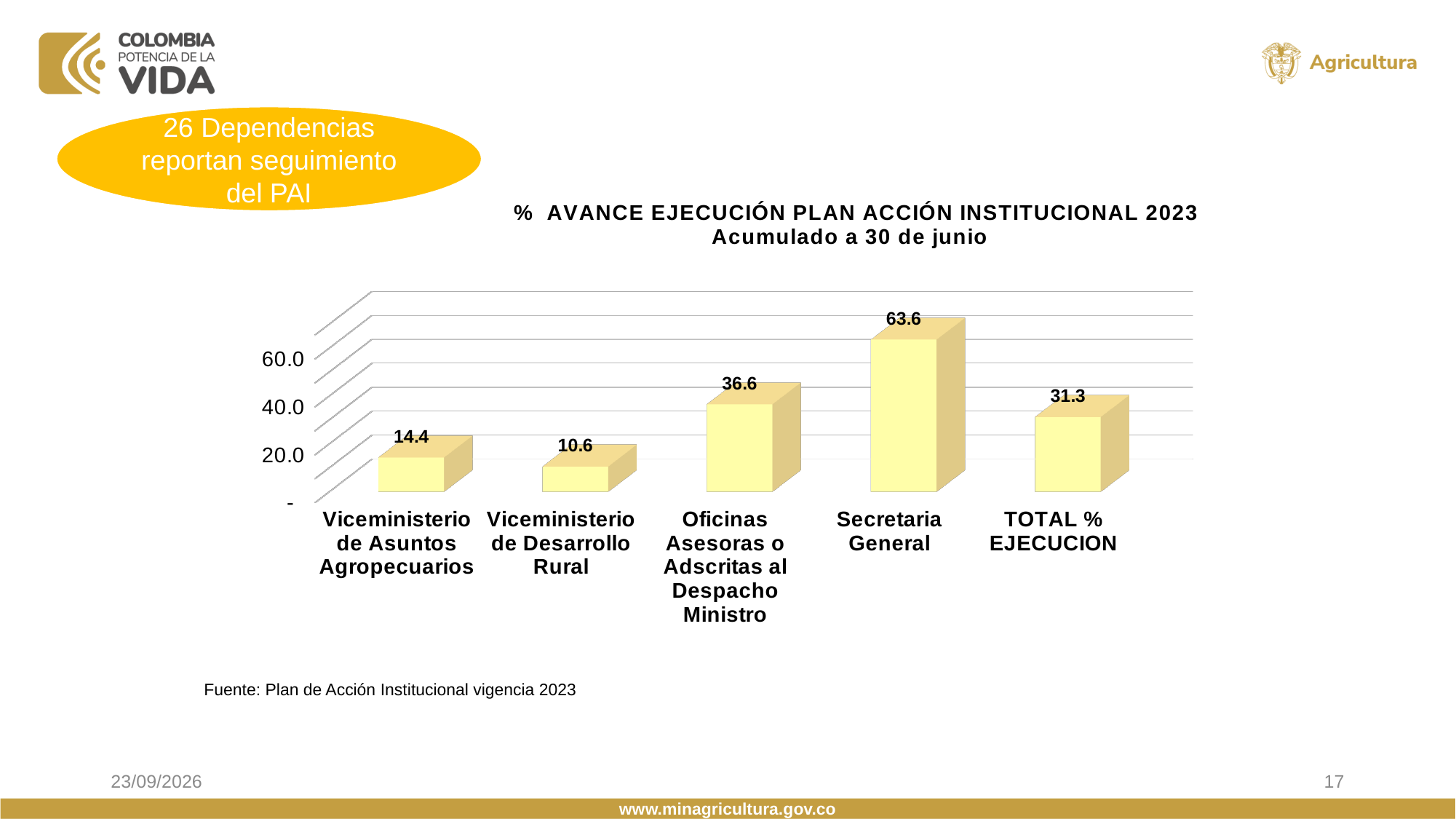
Which category has the highest value? Secretaria General What kind of chart is shown on the slide? Bar chart Is the value for Secretaria General greater or less than 60.0? greater What is the title of the chart? % AVANCE EJECUCIÓN PLAN ACCIÓN INSTITUCIONAL 2023 Acumulado a 30 de junio What is the value for TOTAL % EJECUCION? 31.3 Which is larger, the value for Viceministerio de Asuntos Agropecuarios or the value for Viceministerio de Desarrollo Rural? Viceministerio de Asuntos Agropecuarios Which category has the lowest value? Viceministerio de Desarrollo Rural What is the value for Secretaria General? 63.6 What is the difference between the values for Secretaria General and Oficinas Asesoras o Adscritas al Despacho Ministro? 27.0 What is the value for Viceministerio de Desarrollo Rural? 10.6 What is the value for Oficinas Asesoras o Adscritas al Despacho Ministro? 36.6 How many categories are shown on the x axis? 5